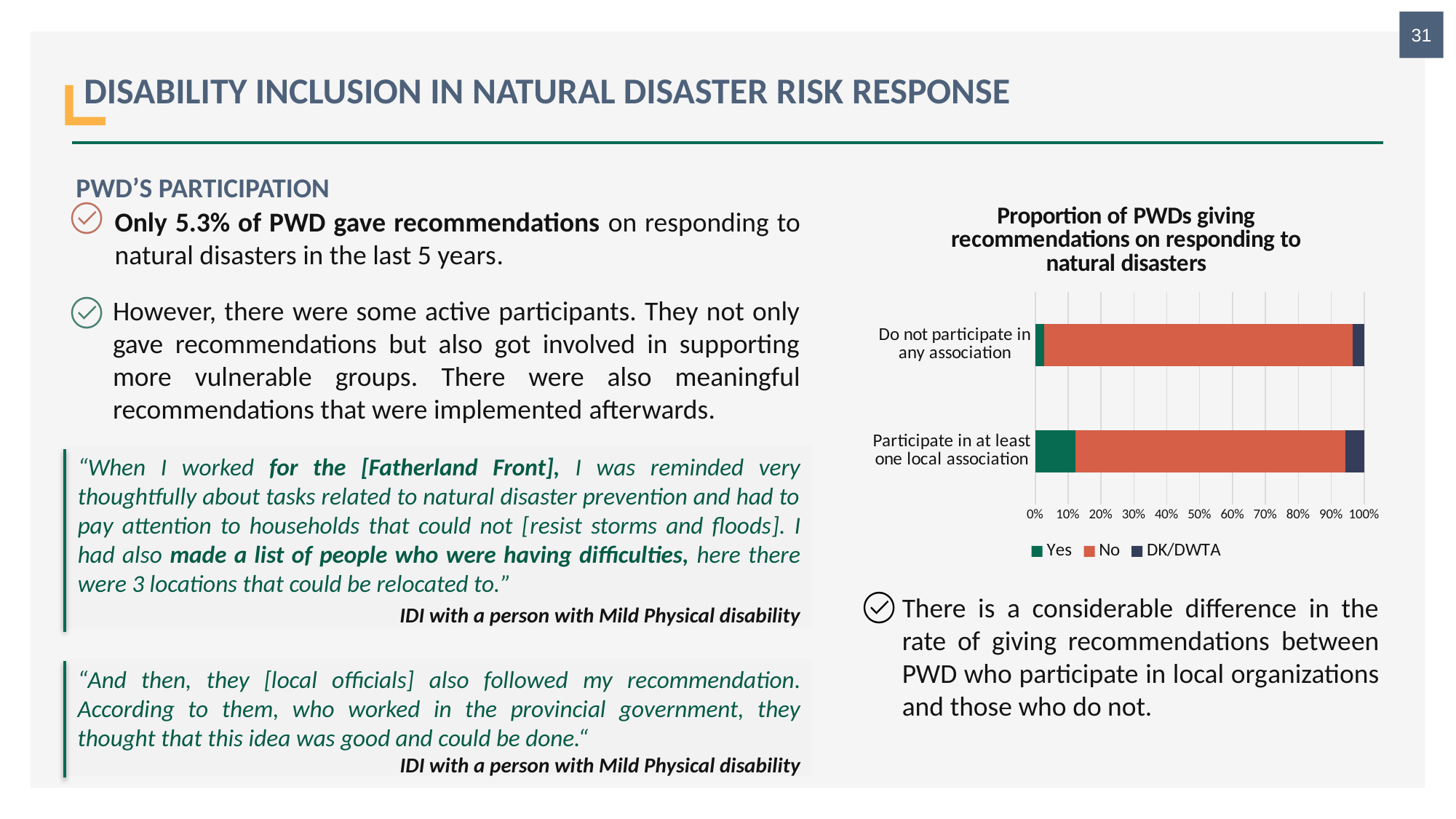
Is the 'No' value for 'Participate in at least one local association' greater or less than 60%? greater Which category has the larger 'Yes' share: 'Participate in at least one local association' or 'Do not participate in any association'? Participate in at least one local association How many categories are plotted on the chart? 2 Which series is shown in green in the chart? Yes What is the title of the chart on the slide? Proportion of PWDs giving recommendations on responding to natural disasters What kind of chart is shown on the slide? Stacked bar chart Is the 'No' value for 'Do not participate in any association' greater or less than 80%? greater Is the 'Yes' value for 'Do not participate in any association' greater or less than 10%? less How many series does the chart's legend list? 3 Which category has the larger 'No' share: 'Participate in at least one local association' or 'Do not participate in any association'? Do not participate in any association Which series makes up the largest share of the bar for 'Participate in at least one local association'? No